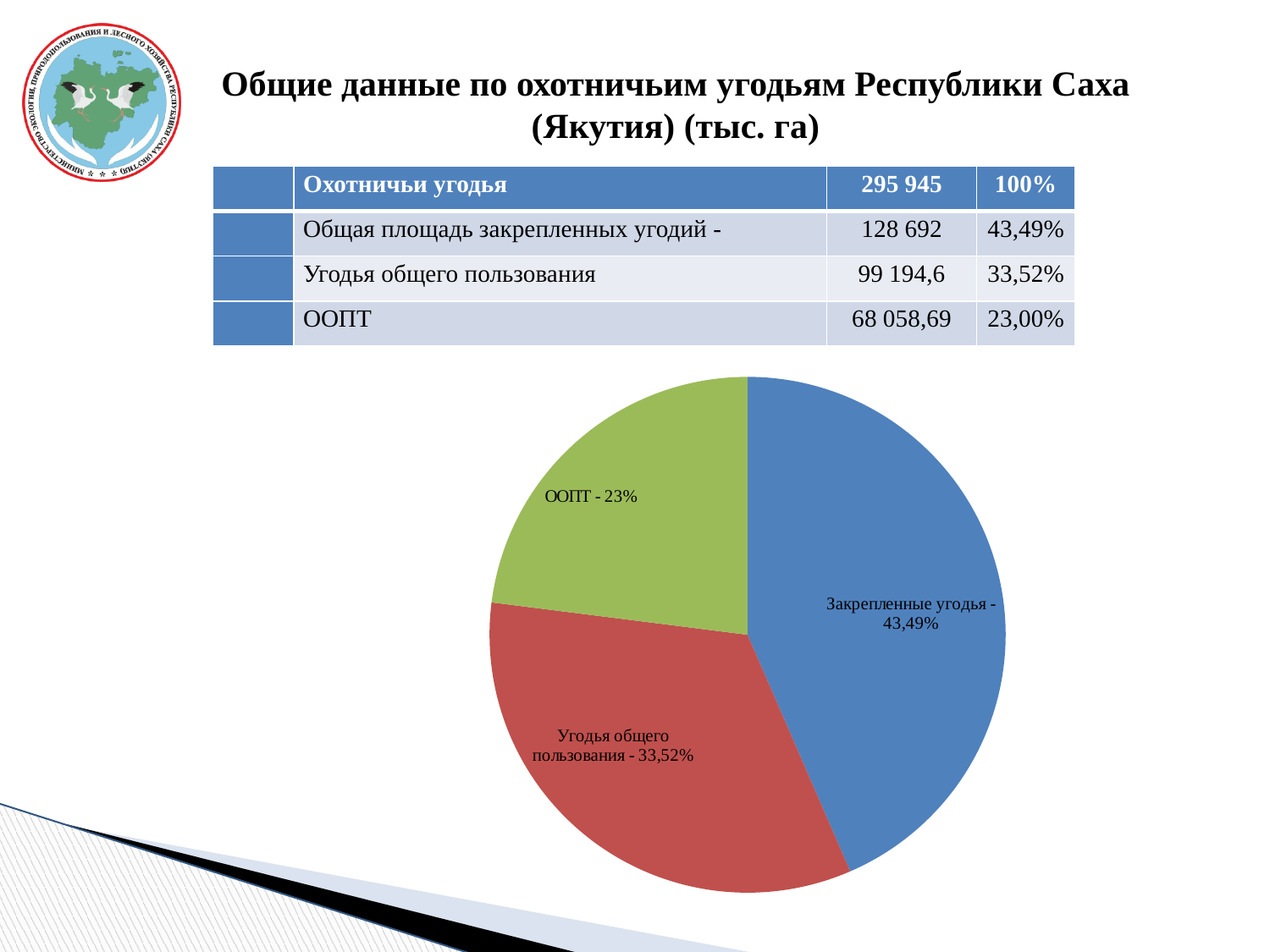
What is the difference in percentage points between the Закрепленные угодья slice and the ООПТ slice? 20,49 What kind of chart is shown on the slide? pie chart What colour is the ООПТ slice in the pie chart? green What colour is the Закрепленные угодья slice in the pie chart? blue Which slice of the pie chart is the largest? Закрепленные угодья Which is larger in the pie chart: Угодья общего пользования or ООПТ? Угодья общего пользования What is the difference in percentage points between the Закрепленные угодья slice and the Угодья общего пользования slice? 9,97 What share of the pie does the slice "Угодья общего пользования" represent? 33,52% How many slices does the pie chart have? 3 What share of the pie does the slice "ООПТ" represent? 23% Which slice of the pie chart is the smallest? ООПТ What share of the pie does the slice "Закрепленные угодья" represent? 43,49%